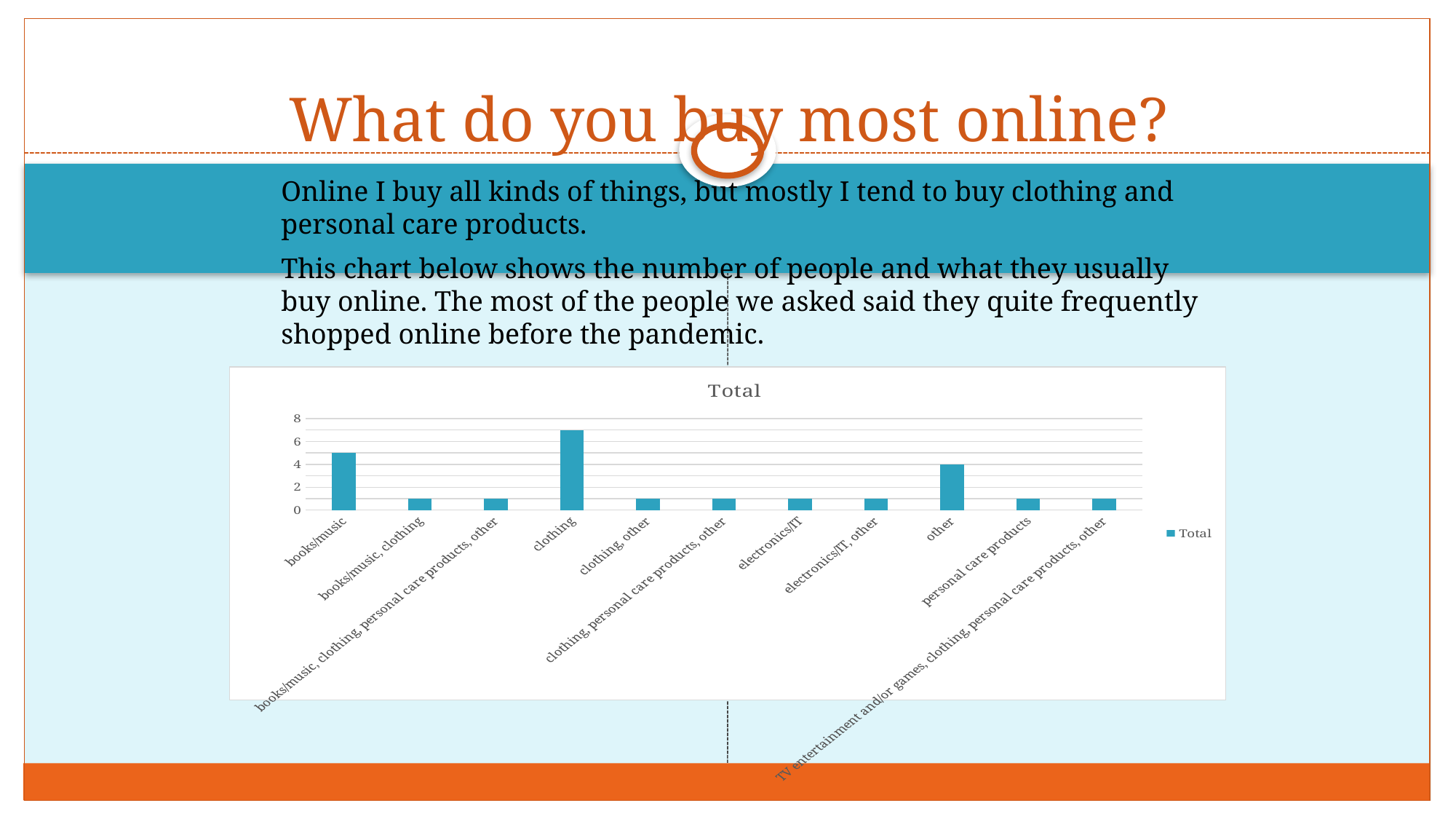
Which is larger, the value for other or the value for personal care products? other Is the value for electronics/IT greater or less than 2? less What is the title of the chart? Total Which category has the highest value in the chart? clothing Is the value for books/music greater or less than 6? less What kind of chart is shown on the slide? bar chart Is the value for books/music greater or less than 4? greater Which is larger, the value for clothing or the value for books/music? clothing How many categories are shown on the x axis of the chart? 11 What is the value for the category other? 4 How many series does the legend list? 1